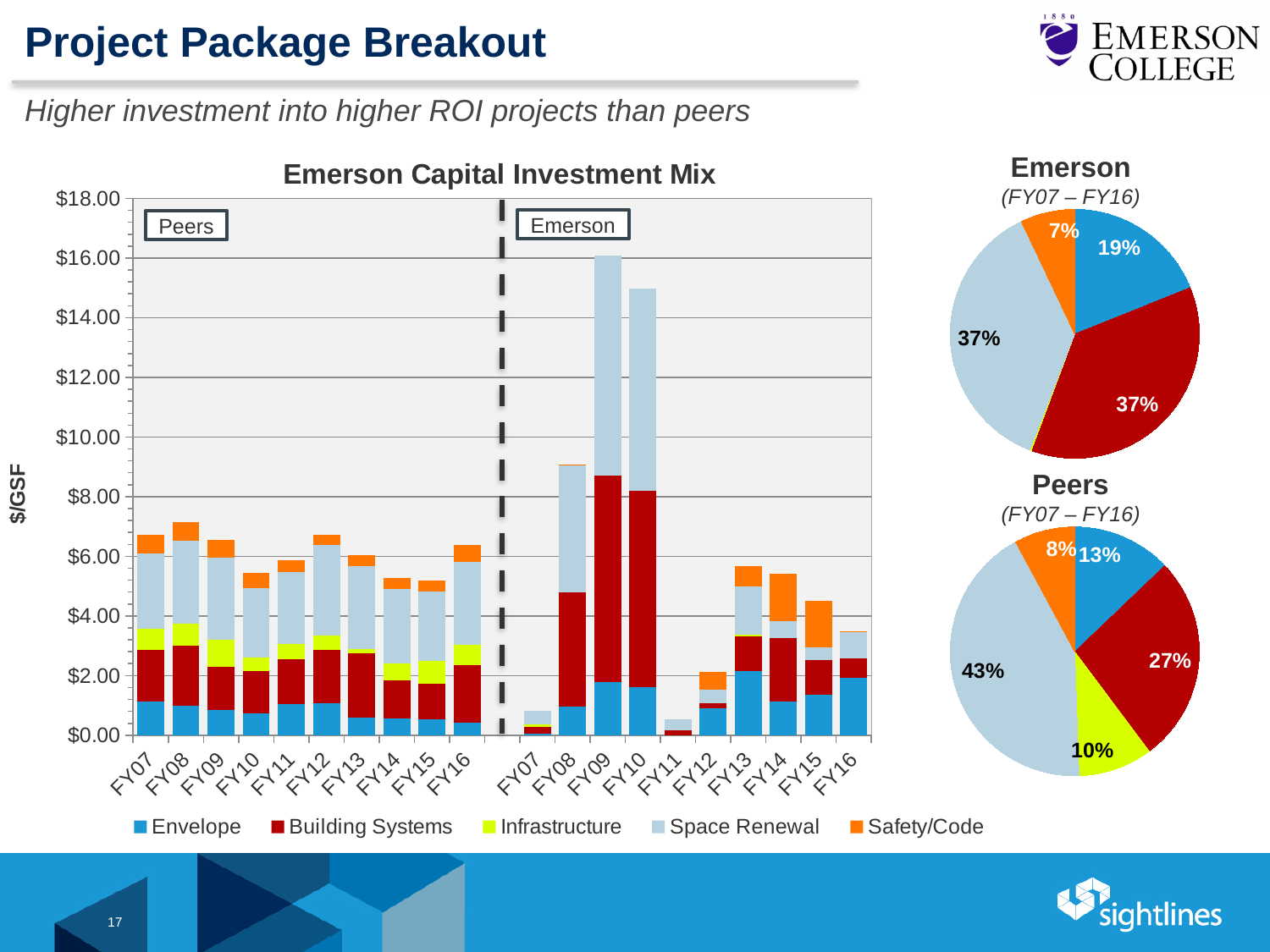
In the Peers (FY07 – FY16) pie chart, what is the difference between the Space Renewal share and the Building Systems share? 16 percentage points What kind of chart is the "Emerson Capital Investment Mix" chart? Stacked bar chart In the "Emerson Capital Investment Mix" chart, which fiscal year has the tallest bar in the Emerson group? FY09 In the Emerson (FY07 – FY16) pie chart, what share is Safety/Code? 7% In the "Emerson Capital Investment Mix" chart, which is larger: the FY09 bar for Peers or the FY09 bar for Emerson? Emerson In the "Emerson Capital Investment Mix" chart, how many fiscal years are shown in the Emerson group? 10 In the Emerson (FY07 – FY16) pie chart, what share is Space Renewal? 37% Which is larger: the Envelope share in the Emerson pie chart or the Envelope share in the Peers pie chart? Emerson (19%) How many series does the legend of the "Emerson Capital Investment Mix" chart list? 5 In the Peers (FY07 – FY16) pie chart, which category has the largest share? Space Renewal In the "Emerson Capital Investment Mix" chart, is the total for Emerson FY11 greater or less than $2.00? less In the "Emerson Capital Investment Mix" chart, is the total for Emerson FY09 greater or less than $14.00? greater